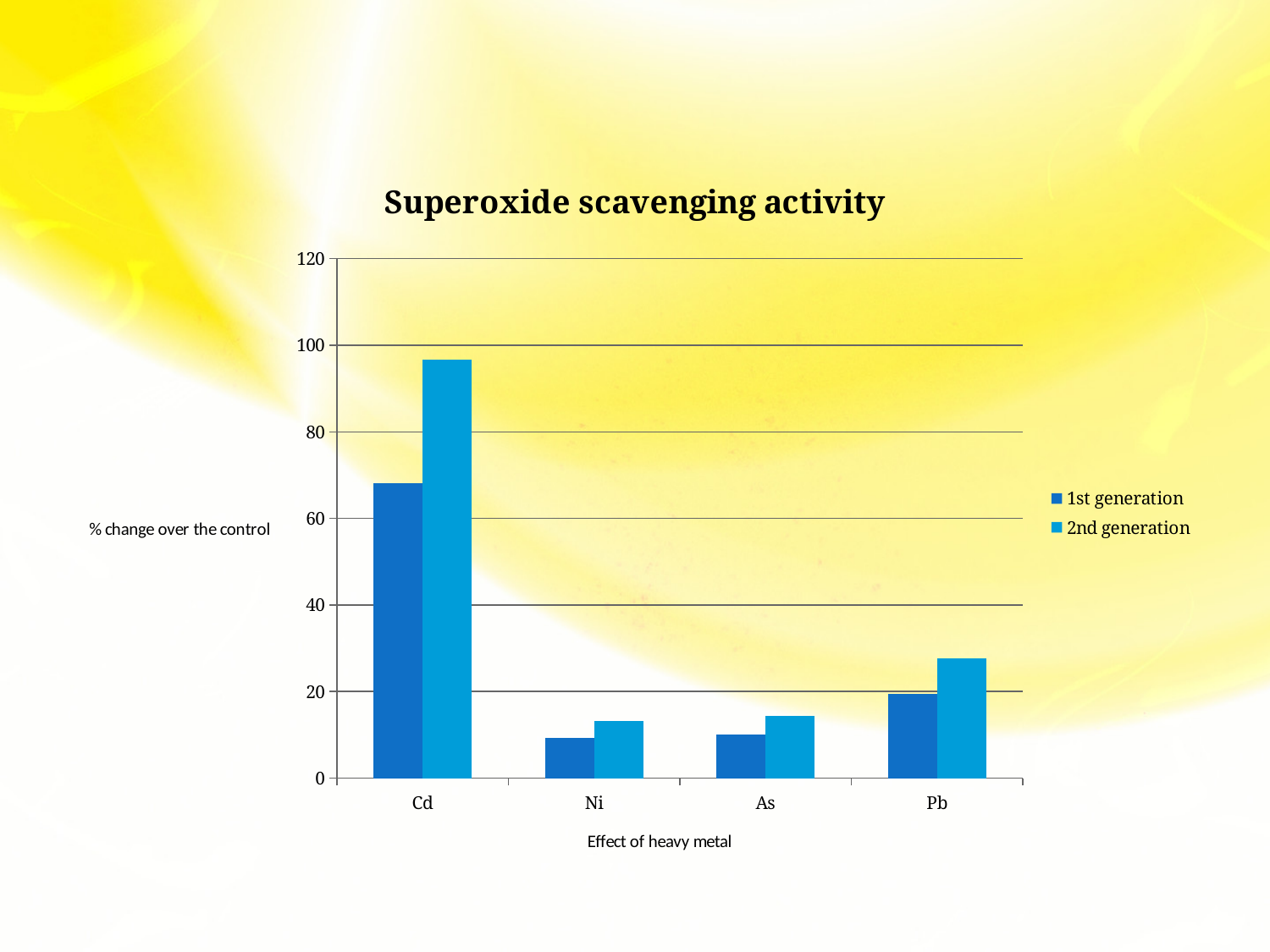
Is the 2nd generation value for Ni greater or less than 20? less Which heavy metal has the highest 2nd generation value? Cd Which is larger: the 2nd generation value for Pb or the 2nd generation value for As? Pb How many series does the legend list? 2 What kind of chart is shown on the slide? bar chart Is the 1st generation value for Cd greater or less than 60? greater Is the 2nd generation value for Pb greater or less than 20? greater For Cd, which is larger: the 1st generation value or the 2nd generation value? 2nd generation Which heavy metal has the highest 1st generation value? Cd What is the title of the chart? Superoxide scavenging activity How many heavy metal categories are shown on the x axis? 4